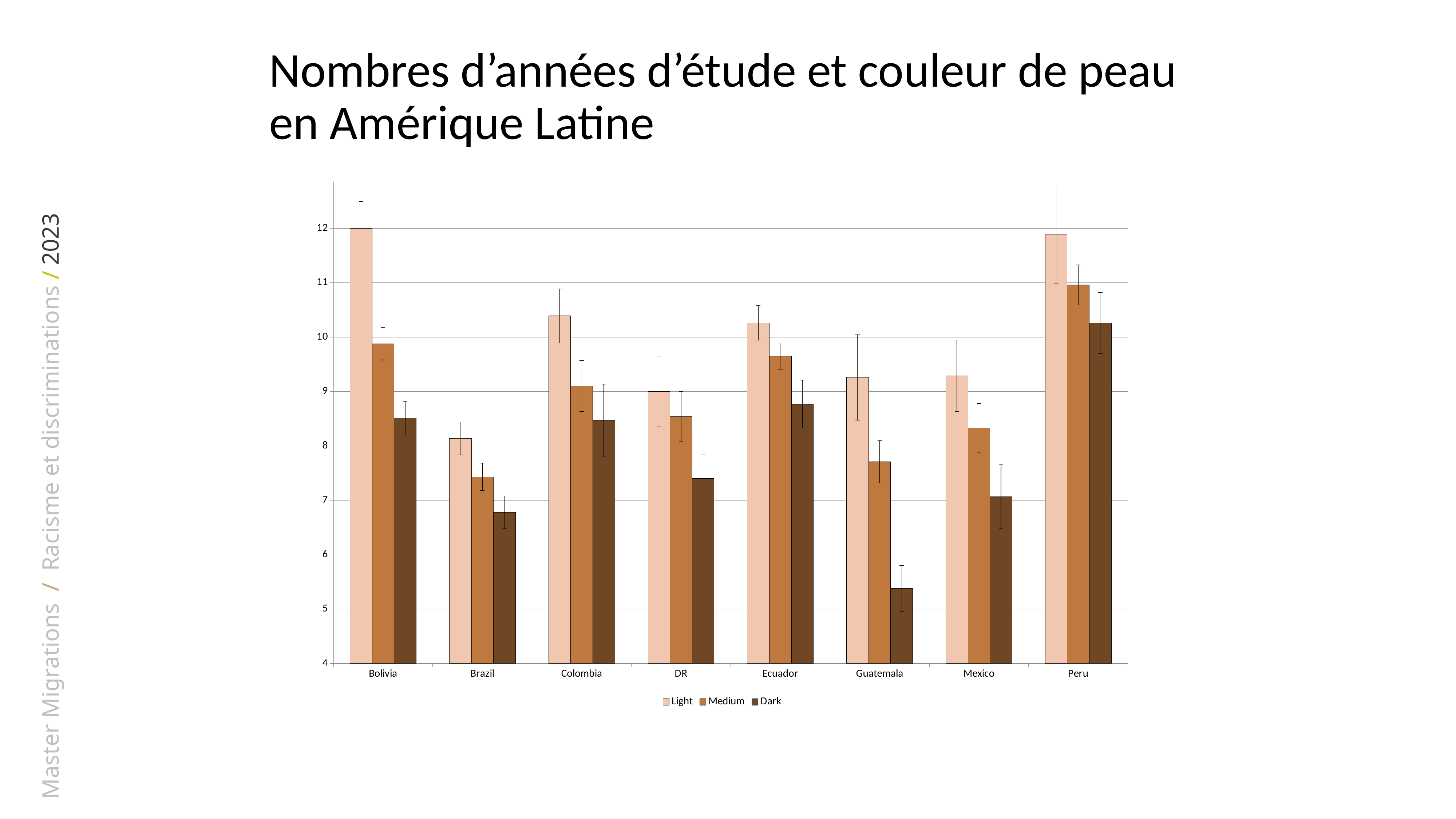
Which country has the lowest Light bar? Brazil Which country has the highest Dark bar? Peru Is the Dark value for Guatemala greater or less than 6? less Which country has the lowest Dark bar? Guatemala What is the value of the Light bar for Bolivia? 12 Is the Light value for Peru greater or less than 11? greater How many series does the chart's legend list? 3 Is the Dark value for Brazil greater or less than 7? less What kind of chart is shown on the slide? bar chart What are the three series listed in the legend? Light, Medium, Dark How many countries are shown on the x axis of the chart? 8 Which is larger, the Medium bar for Bolivia or the Medium bar for Colombia? Bolivia